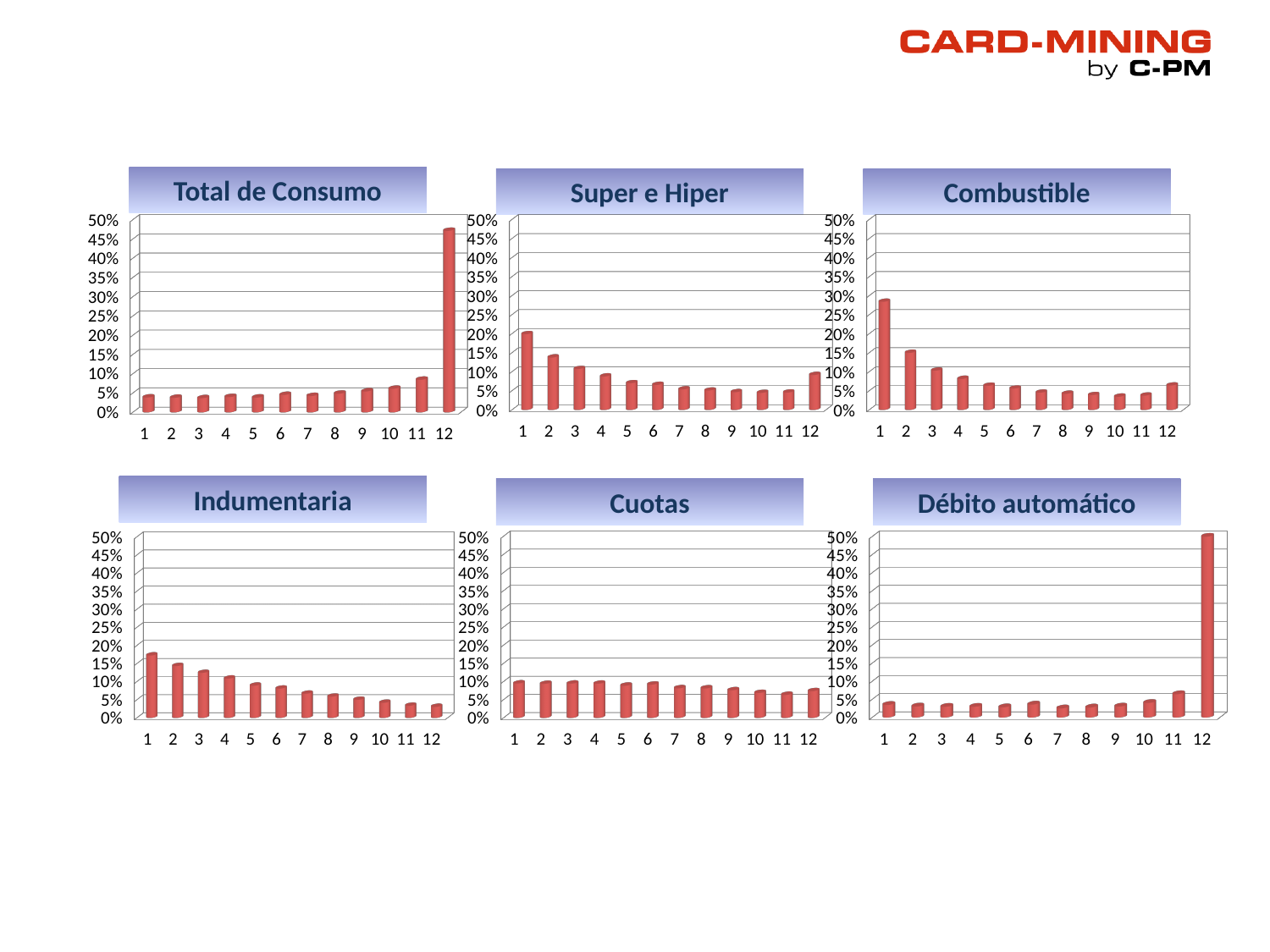
In the "Indumentaria" chart, do the values generally rise or fall from category 1 to category 12? fall In the "Combustible" chart, which is larger, the value for category 1 or the value for category 12? category 1 In the "Combustible" chart, is the value for category 1 greater or less than 25%? greater In the "Super e Hiper" chart, which category has the highest value? 1 How many categories are shown on the x axis of the "Super e Hiper" chart? 12 In the "Indumentaria" chart, is the value for category 1 greater or less than 15%? greater In the "Débito automático" chart, which category has the highest value? 12 How many charts are shown on the slide? 6 In the "Total de Consumo" chart, is the value for category 12 greater or less than 40%? greater What kind of chart is the "Total de Consumo" chart? bar chart In the "Total de Consumo" chart, which category has the highest value? 12